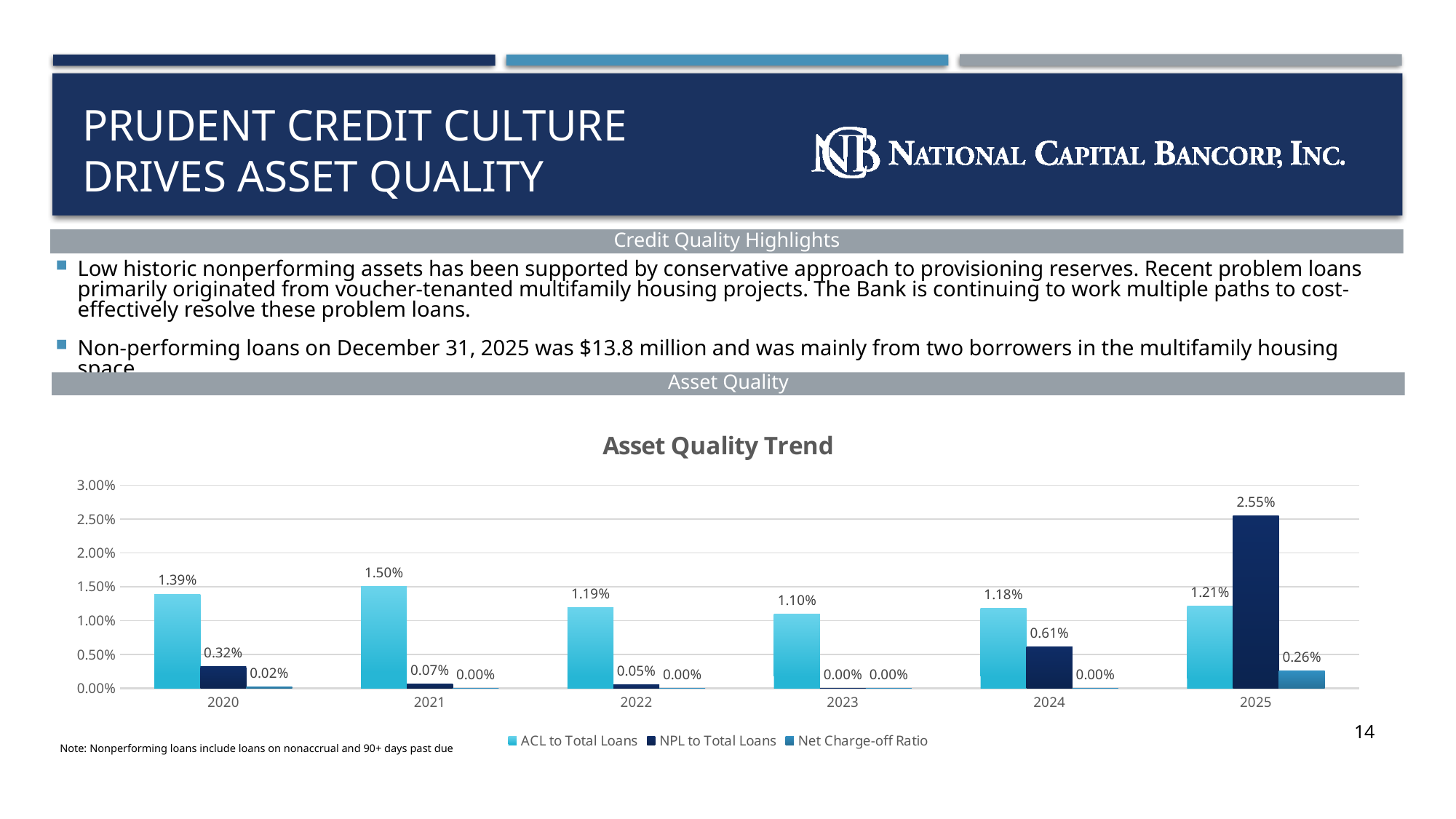
What is the ACL to Total Loans value for 2021? 1.50% How many series does the legend of the Asset Quality Trend chart list? 3 How many years are shown on the x axis of the Asset Quality Trend chart? 6 Is the NPL to Total Loans value for 2025 greater or less than 2.00%? greater What kind of chart is the Asset Quality Trend chart? Bar chart Which year has the lowest ACL to Total Loans value? 2023 Which is larger in 2025: ACL to Total Loans or NPL to Total Loans? NPL to Total Loans What is the NPL to Total Loans value for 2025? 2.55% What is the Net Charge-off Ratio for 2020? 0.02% Which year has the highest ACL to Total Loans value? 2021 What is the NPL to Total Loans value for 2024? 0.61% What is the difference between the NPL to Total Loans values for 2025 and 2024? 1.94%